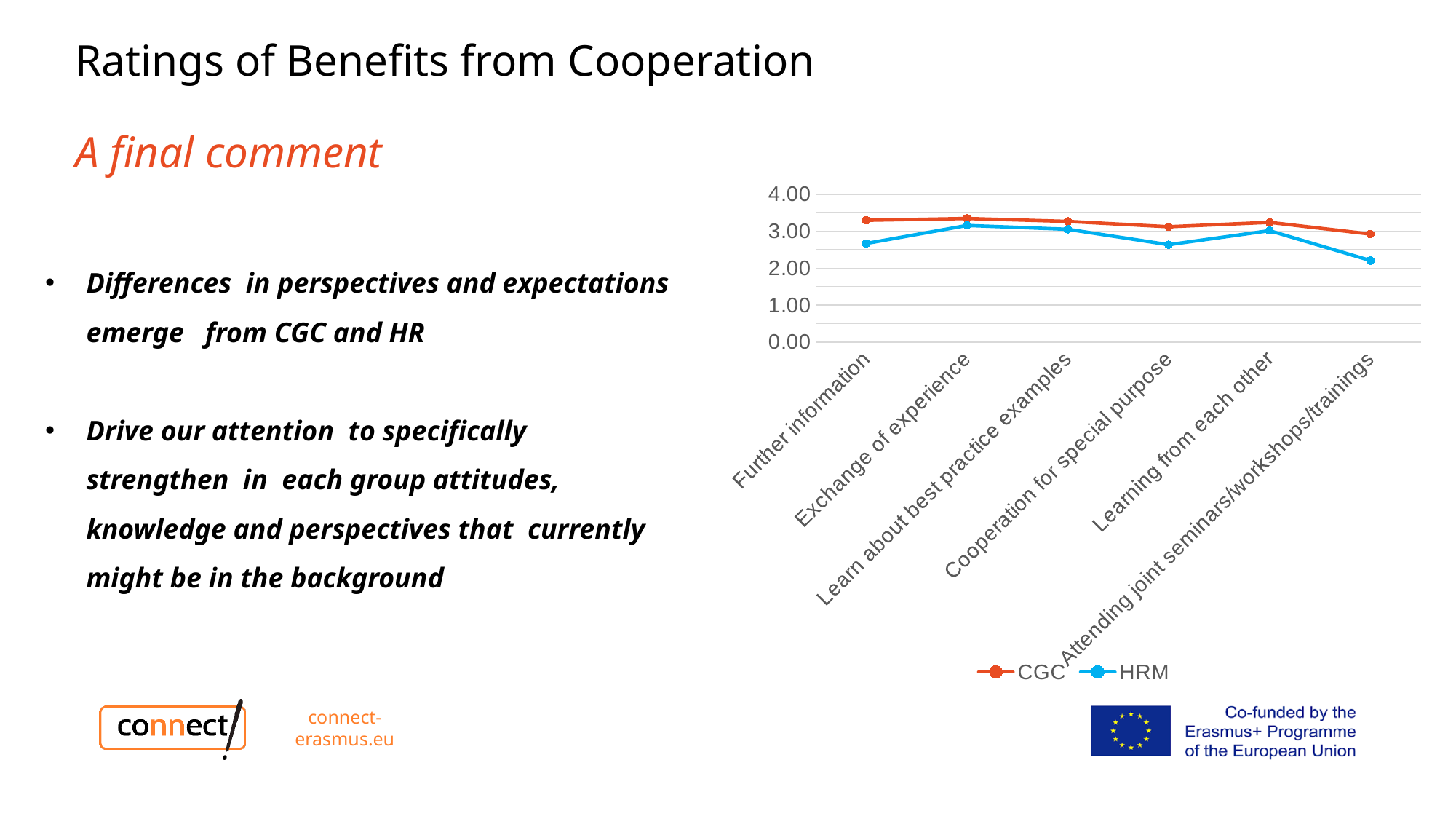
How many categories are plotted along the x axis of the chart? 6 Which series is drawn in blue in the chart? HRM Is the CGC value for Further information greater or less than 3.00? greater For Attending joint seminars/workshops/trainings, which series has the higher value, CGC or HRM? CGC Is the CGC value for Attending joint seminars/workshops/trainings greater or less than 2.00? greater For Further information, which series has the higher value, CGC or HRM? CGC Is the HRM value for Further information greater or less than 3.00? less What kind of chart is shown on the slide? line chart How many series does the chart legend list? 2 Which category has the lowest HRM value? Attending joint seminars/workshops/trainings